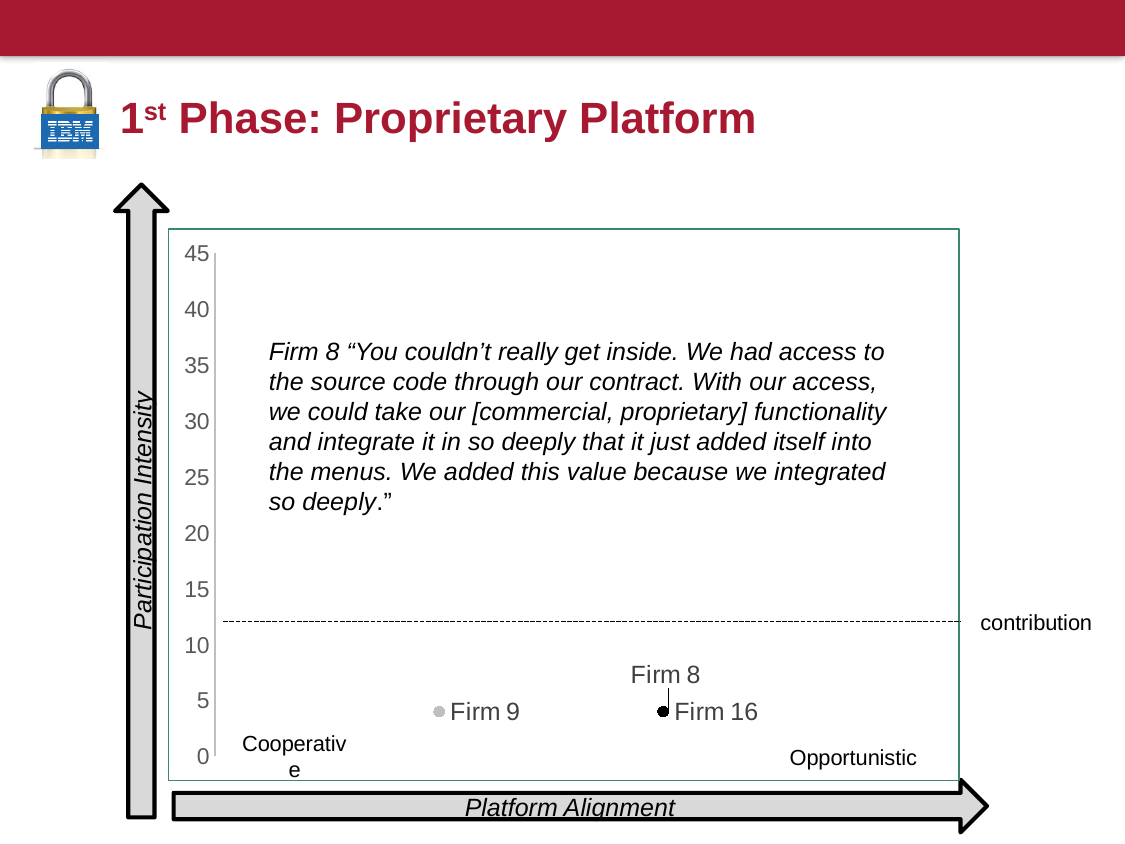
Which firm is plotted further toward the Opportunistic end of the Platform Alignment axis, Firm 9 or Firm 16? Firm 16 How many firms are plotted as labeled points on the chart? 3 What kind of chart is shown on the slide? scatter chart Is the Participation Intensity value for Firm 9 greater or less than 10? less Is the Participation Intensity value for Firm 8 greater or less than 15? less What is the label of the horizontal axis of the chart? Platform Alignment Which firm is plotted closest to the Cooperative end of the Platform Alignment axis? Firm 9 Is the dashed horizontal line labeled 'contribution' above or below the plotted firm points? above What is the highest tick value shown on the vertical axis? 45 What is the label of the vertical axis of the chart? Participation Intensity Is the Participation Intensity value for Firm 16 greater or less than 10? less